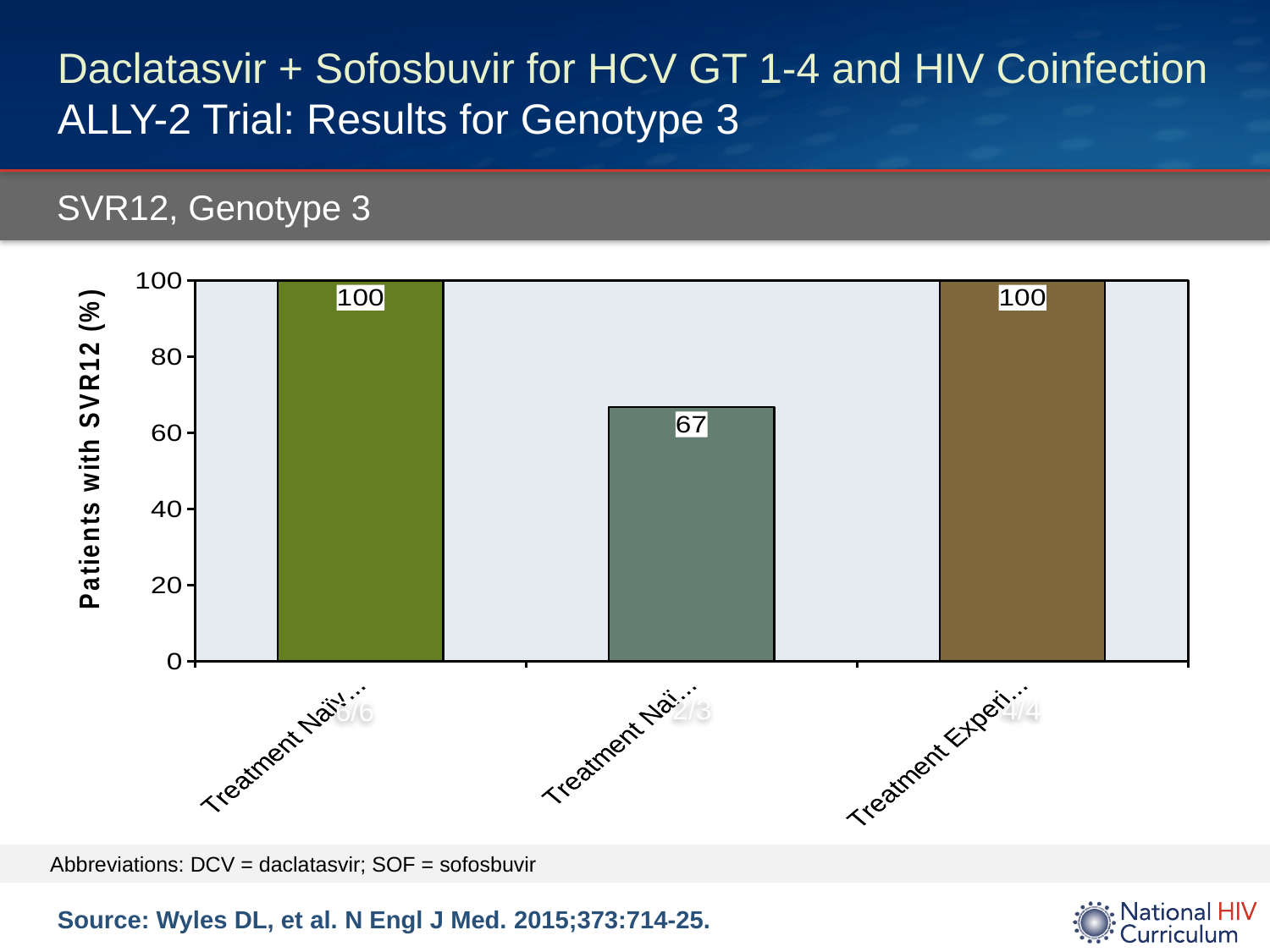
What is the title of the y-axis? Patients with SVR12 (%) Which bar has the lowest value? the middle bar (67) What is the value shown on the leftmost (green) bar? 100 What is the value shown on the middle (grey-green) bar? 67 What is the heading shown above the chart? SVR12, Genotype 3 Which is larger, the value of the leftmost bar or the middle bar? the leftmost bar Is the value of the rightmost bar greater or less than 80? greater What is the difference between the value of the leftmost bar and the middle bar? 33 What kind of chart is shown on the slide? bar chart Is the value of the middle bar greater or less than 80? less What is the value shown on the rightmost (brown) bar? 100 How many bars are plotted in the chart? 3